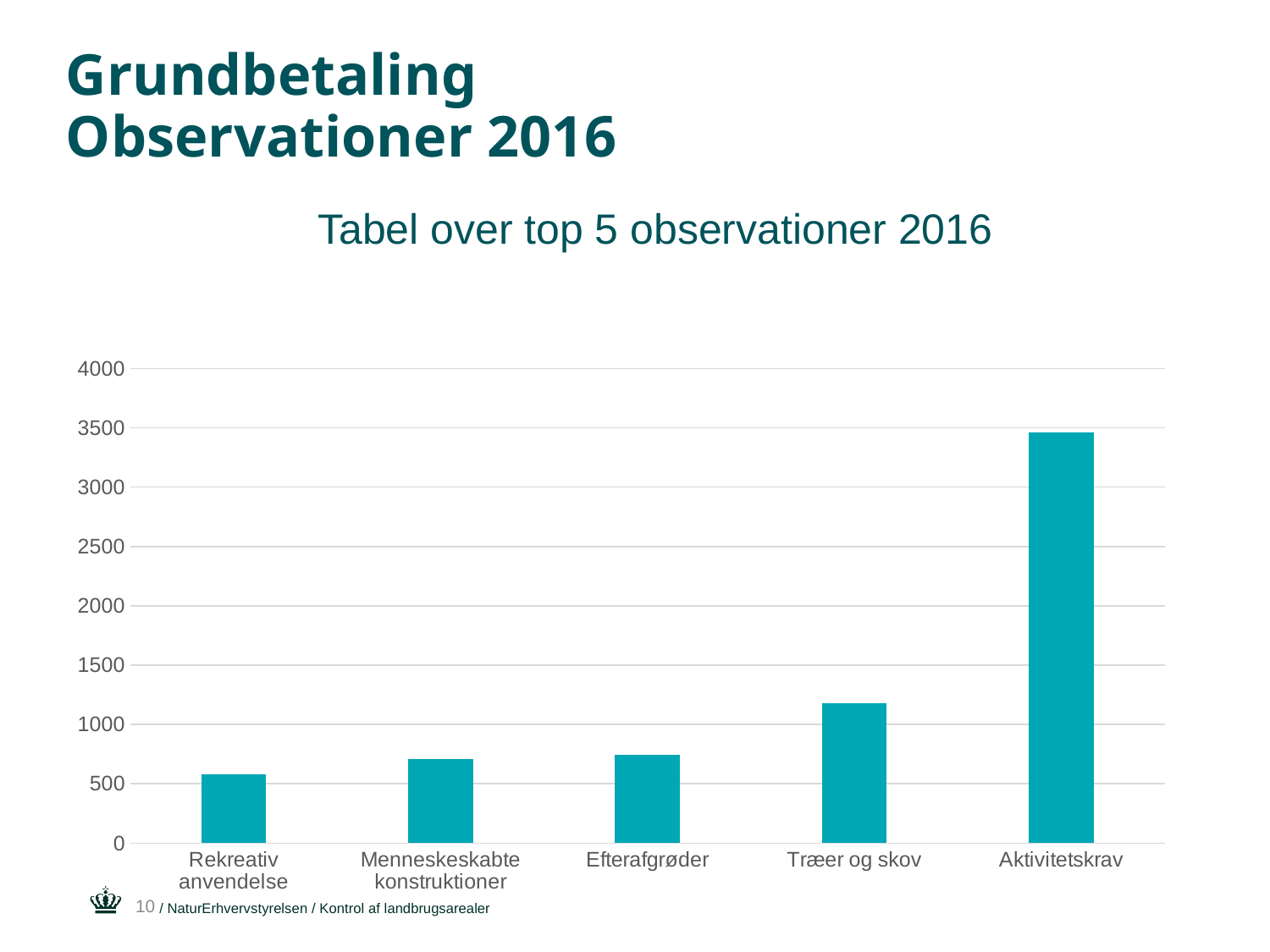
How many categories are shown on the x axis of the chart? 5 Is the value for Aktivitetskrav greater or less than 3000? greater Do the bar values rise or fall from left to right along the x axis? Rise Which category has the highest value in the chart? Aktivitetskrav Is the value for Efterafgrøder greater or less than 1000? less Is the value for Træer og skov greater or less than 1000? greater Which category has the lowest value in the chart? Rekreativ anvendelse Which is larger, the value for Træer og skov or the value for Efterafgrøder? Træer og skov Which is larger, the value for Aktivitetskrav or the value for Træer og skov? Aktivitetskrav What is the title shown above the chart? Tabel over top 5 observationer 2016 What kind of chart is shown on the slide? Bar chart